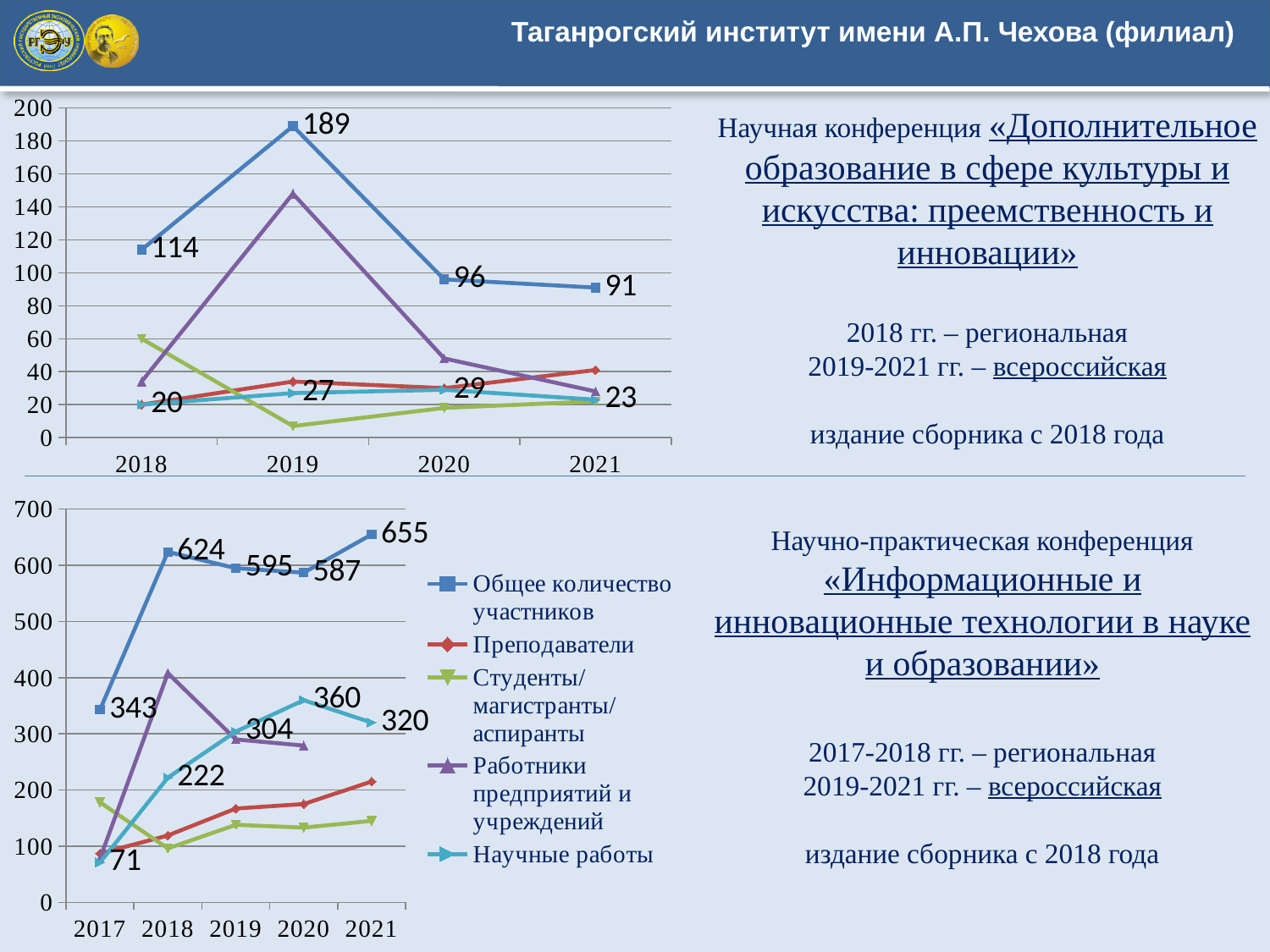
In the bottom chart, what is the difference between Общее количество участников in 2018 and in 2017? 281 What kind of chart is the bottom chart? Line chart In the top chart, is the value of the purple line in 2019 greater or less than 100? greater In the bottom chart, in which year is Общее количество участников highest? 2021 In the top chart, in which year does the blue line reach its highest value? 2019 In the bottom chart, in which year is Общее количество участников lowest? 2017 In the bottom chart, is the value of Научные работы larger in 2020 or in 2021? 2020 How many years are shown on the x axis of the bottom chart? 5 How many series does the legend of the bottom chart list? 5 In the bottom chart, what is the value of Общее количество участников in 2021? 655 In the top chart, what is the difference between the blue line's values in 2019 and 2018? 75 In the bottom chart, what is the value of Научные работы in 2017? 71